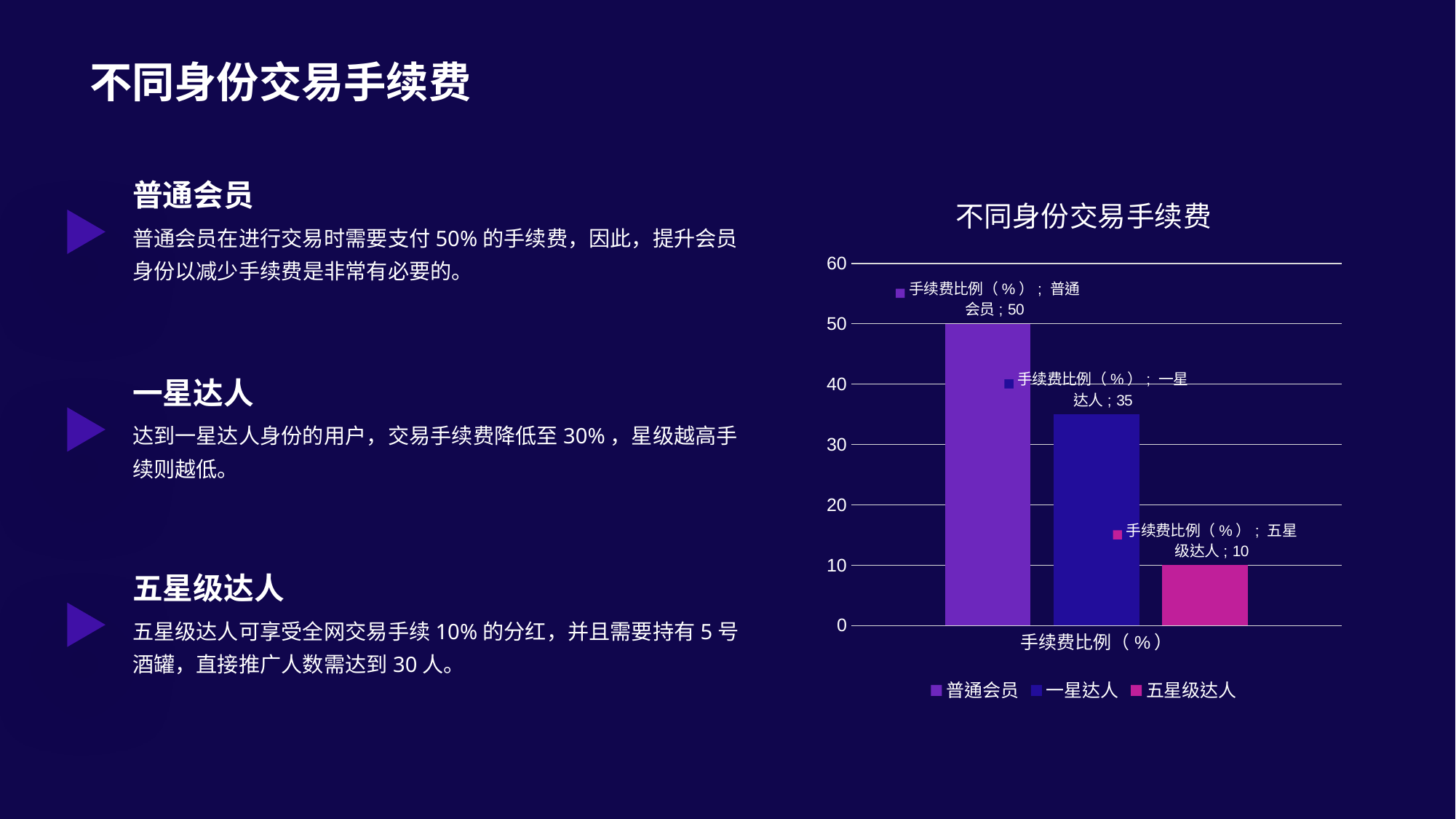
What is the difference between the values for 普通会员 and 一星达人? 15 Which series has the lowest value in the chart? 五星级达人 What is the title of the chart? 不同身份交易手续费 What kind of chart is shown on the slide? bar chart Is the value for 一星达人 greater or less than 40? less What is the value for 一星达人 in the chart? 35 What is the difference between the values for 一星达人 and 五星级达人? 25 Which is larger, the value for 一星达人 or the value for 五星级达人? 一星达人 Which series has the highest value in the chart? 普通会员 What is the value for 五星级达人 in the chart? 10 What is the value for 普通会员 in the chart? 50 How many series does the legend list? 3